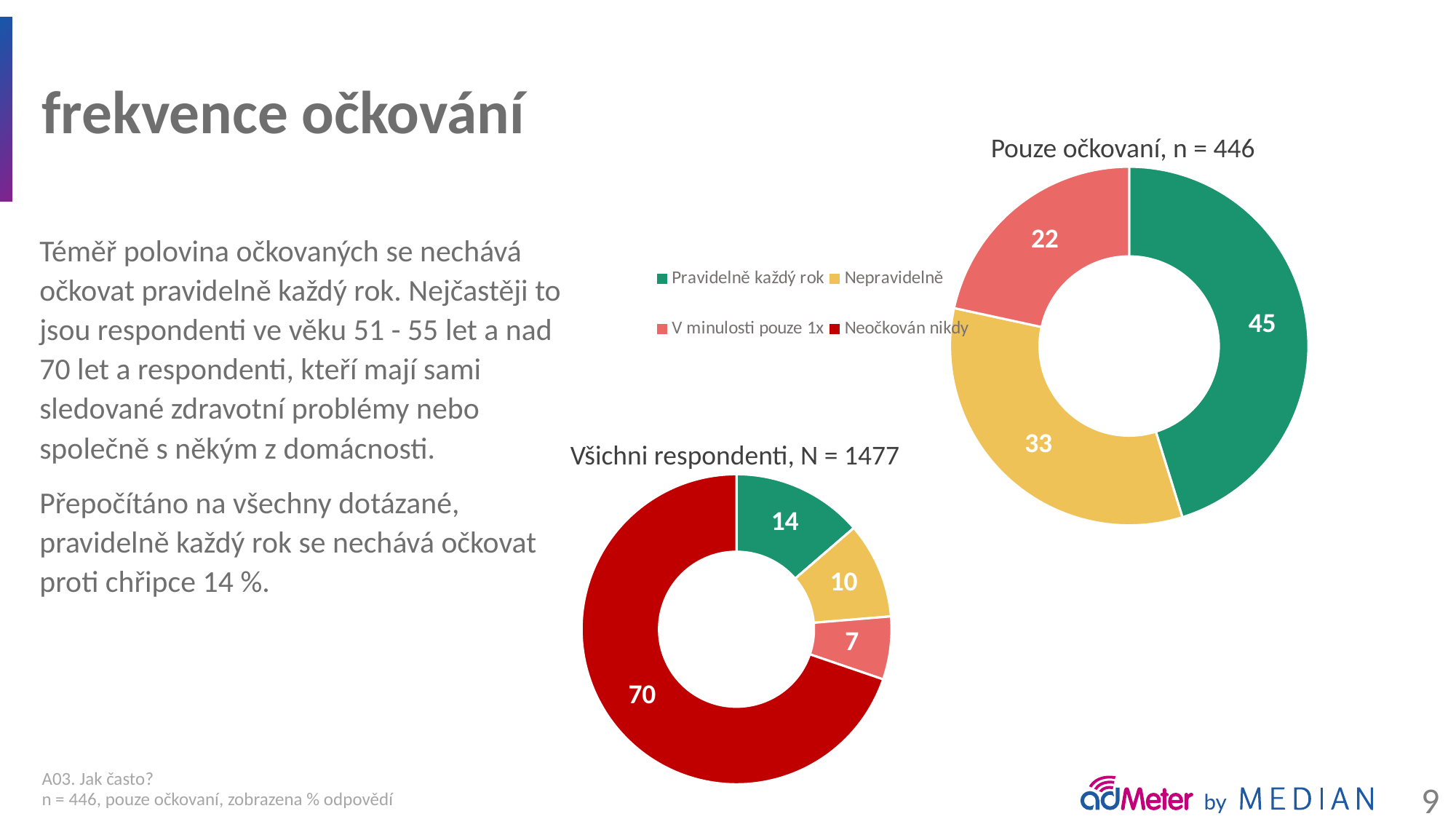
In the 'Všichni respondenti, N = 1477' chart, which category has the smallest share? V minulosti pouze 1x In the 'Pouze očkovaní, n = 446' chart, what is the value for 'Nepravidelně'? 33 In the 'Pouze očkovaní, n = 446' chart, what is the value for 'Pravidelně každý rok'? 45 How many slices does the 'Všichni respondenti, N = 1477' chart have? 4 In the 'Pouze očkovaní, n = 446' chart, which category has the largest share? Pravidelně každý rok How many slices does the 'Pouze očkovaní, n = 446' chart have? 3 In the 'Všichni respondenti, N = 1477' chart, which is larger: 'Pravidelně každý rok' or 'Nepravidelně'? Pravidelně každý rok In the 'Pouze očkovaní, n = 446' chart, what is the difference between 'Pravidelně každý rok' and 'V minulosti pouze 1x'? 23 In the 'Všichni respondenti, N = 1477' chart, what is the difference between 'Neočkován nikdy' and 'Pravidelně každý rok'? 56 In the 'Všichni respondenti, N = 1477' chart, what is the value for 'V minulosti pouze 1x'? 7 What type of chart is used for 'Pouze očkovaní, n = 446'? Doughnut (pie) chart In the 'Všichni respondenti, N = 1477' chart, what is the value for 'Neočkován nikdy'? 70